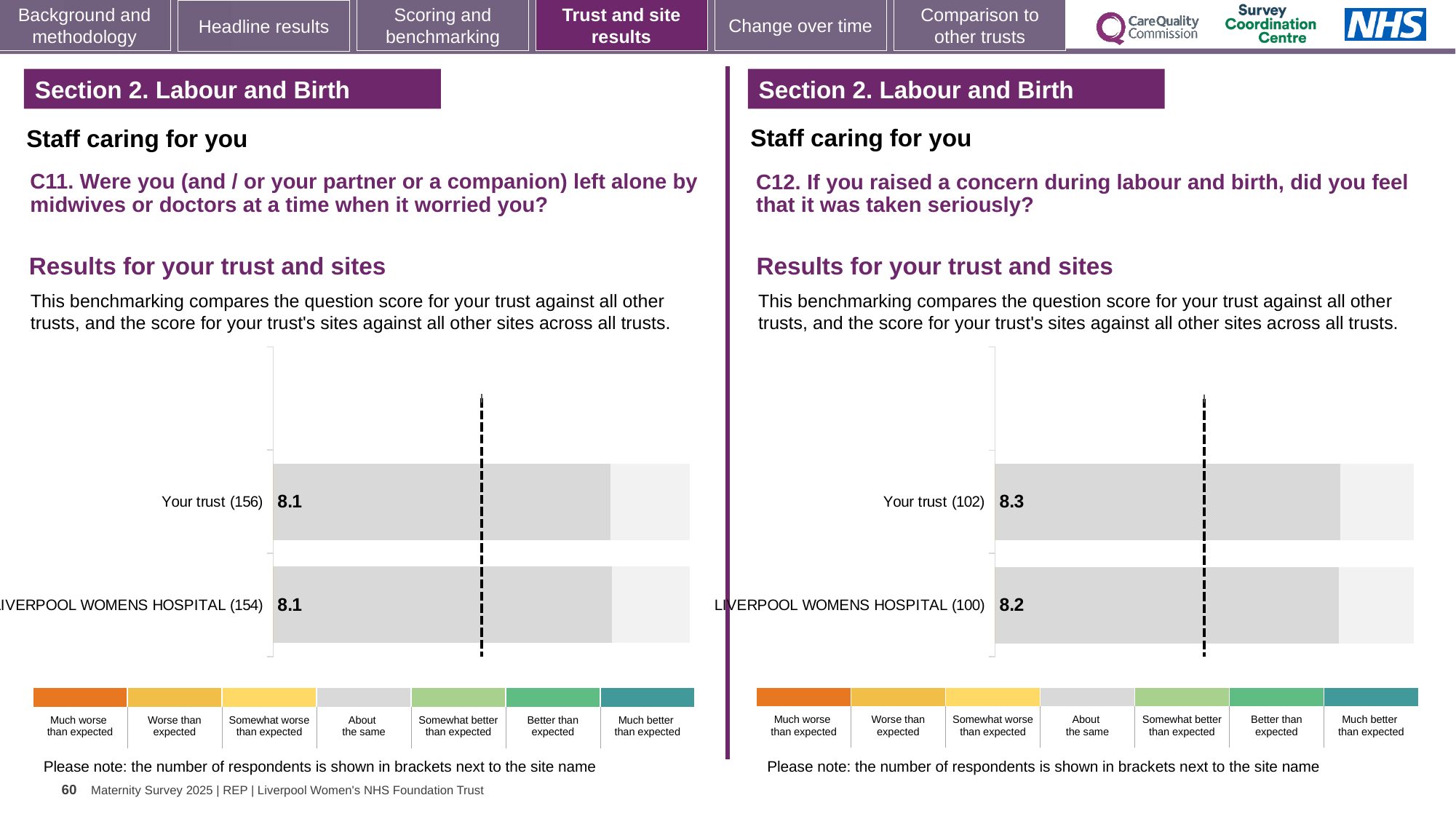
On the C12 chart (right), what is the difference between the score for Your trust and the score for LIVERPOOL WOMENS HOSPITAL? 0.1 On the C12 chart (right), how many respondents are shown in brackets for LIVERPOOL WOMENS HOSPITAL? 100 What type of chart is used on the C12 chart (right)? Bar chart On the C12 chart (right), what is the score for Your trust? 8.3 On the C11 chart (left), what is the score for Your trust? 8.1 How many bars are plotted on the C11 chart (left)? 2 On the C11 chart (left), what is the score for LIVERPOOL WOMENS HOSPITAL? 8.1 On the C12 chart (right), what is the score for LIVERPOOL WOMENS HOSPITAL? 8.2 On the C11 chart (left), how many respondents are shown in brackets for Your trust? 156 On the C12 chart (right), which has the higher score, Your trust or LIVERPOOL WOMENS HOSPITAL? Your trust On the C11 chart (left), what is the difference between the score for Your trust and the score for LIVERPOOL WOMENS HOSPITAL? 0